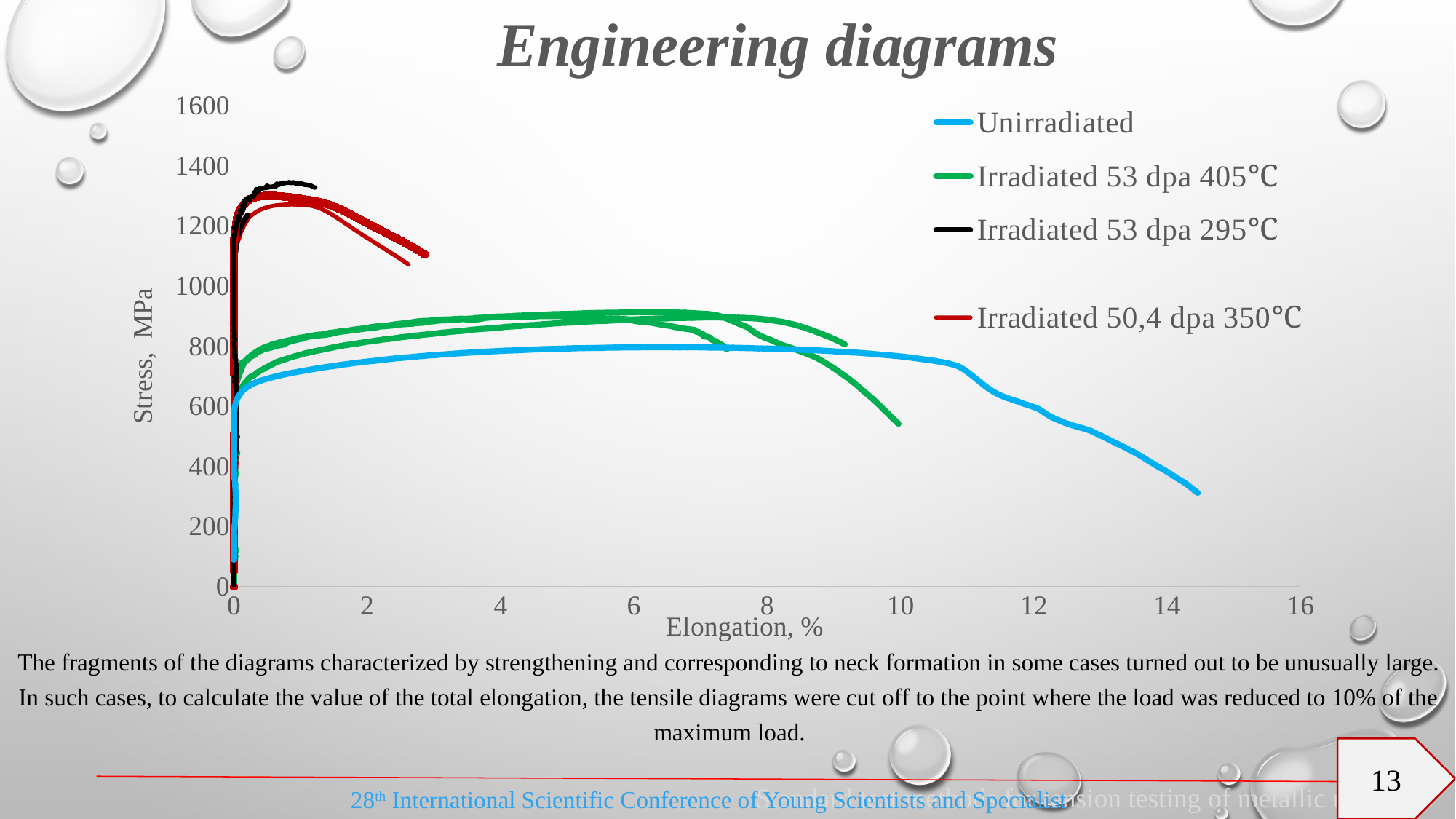
What is the label of the x axis? Elongation, % Is the maximum elongation of the Irradiated 50,4 dpa 350℃ curves greater or less than 4%? less Which series extends to the largest elongation? Unirradiated How many series does the legend list? 4 Is the peak stress of the Irradiated 53 dpa 405℃ curves greater or less than 800 MPa? greater Is the peak stress of the Irradiated 53 dpa 295℃ curve greater or less than 1200 MPa? greater What kind of chart is shown on the slide? line chart Which reaches a higher peak stress, the Irradiated 50,4 dpa 350℃ curve or the Irradiated 53 dpa 405℃ curve? Irradiated 50,4 dpa 350℃ Which extends to a larger elongation, the Unirradiated curve or the Irradiated 53 dpa 295℃ curve? Unirradiated What is the label of the y axis? Stress, MPa Which series reaches the highest stress value? Irradiated 53 dpa 295℃